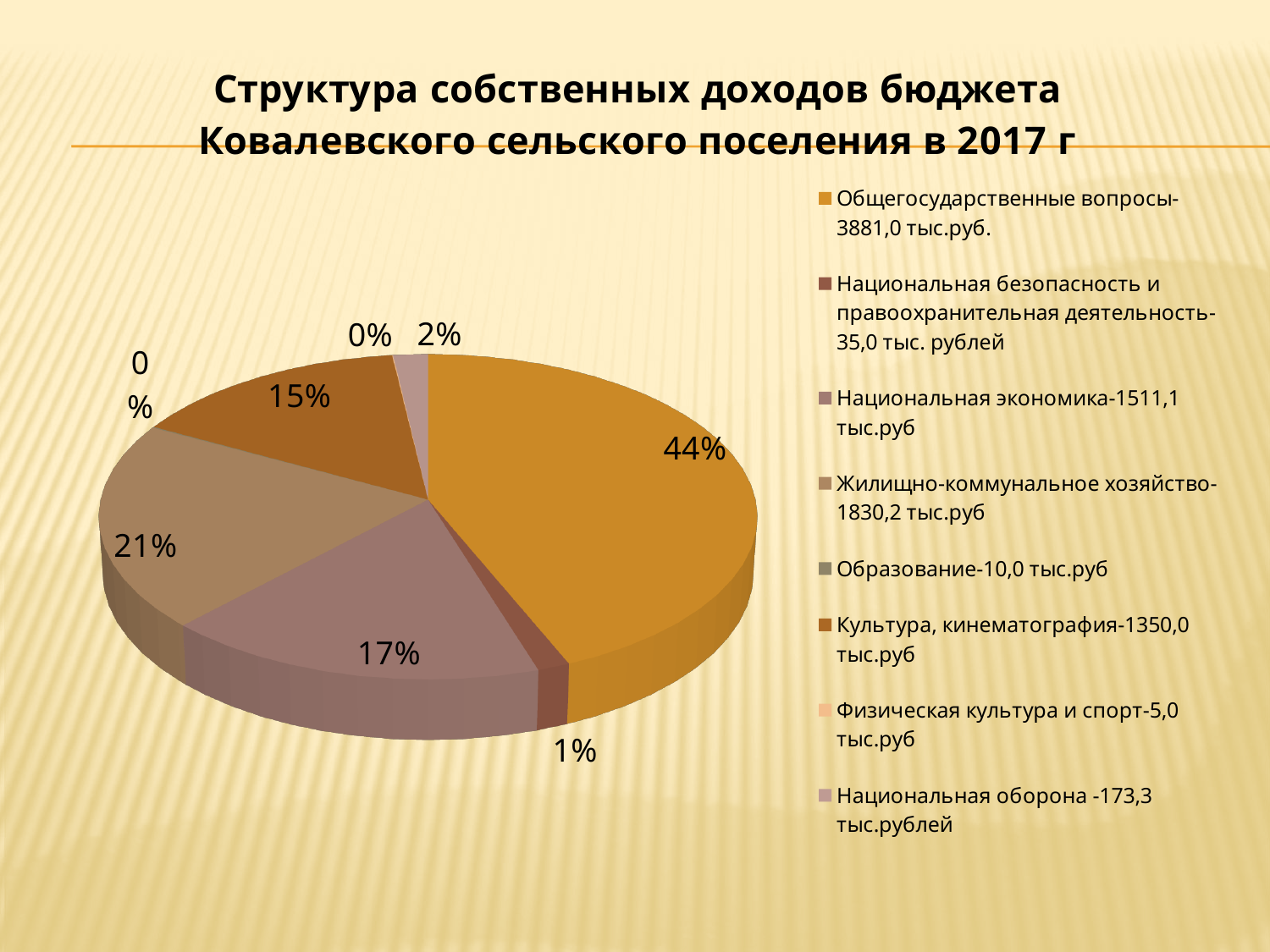
What share of the pie does "Общегосударственные вопросы" take? 44% Which is larger: the slice for "Жилищно-коммунальное хозяйство" or the slice for "Национальная экономика"? Жилищно-коммунальное хозяйство What share of the pie does "Национальная оборона" take? 2% What share of the pie does "Национальная экономика" take? 17% According to the legend, what amount in thousand rubles is given for "Национальная экономика"? 1511,1 тыс.руб What kind of chart is shown on the slide? pie chart How many categories does the legend of the pie chart list? 8 Which category has the largest slice of the pie? Общегосударственные вопросы What is the title of the chart on the slide? Структура собственных доходов бюджета Ковалевского сельского поселения в 2017 г What is the difference in percentage points between the "Общегосударственные вопросы" slice and the "Жилищно-коммунальное хозяйство" slice? 23%